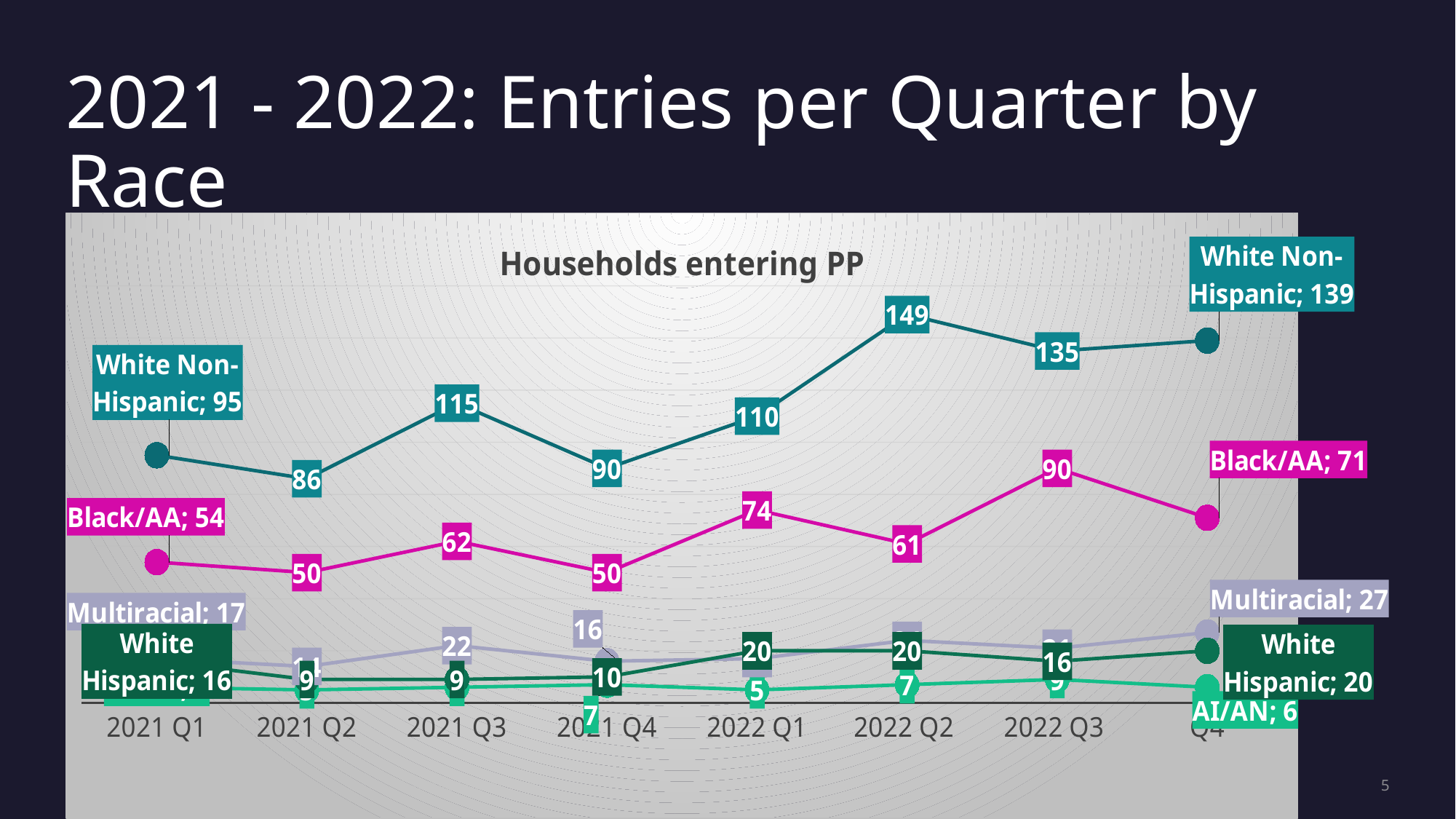
In 2022 Q1, which is larger: White Non-Hispanic or Black/AA? White Non-Hispanic What is the title of the chart? Households entering PP In which quarter does White Non-Hispanic have its lowest value? 2021 Q2 In which quarter does White Non-Hispanic reach its highest value? 2022 Q2 What type of chart is shown on the slide? line chart How many quarters are plotted along the x axis? 8 What is the value for White Non-Hispanic in 2021 Q1? 95 What is the value for Black/AA in 2022 Q3? 90 What is the value for White Non-Hispanic in 2022 Q2? 149 What is the value for Black/AA in 2022 Q4? 71 Does the White Non-Hispanic line rise or fall from 2021 Q4 to 2022 Q2? rise What is the difference between the White Non-Hispanic values in 2022 Q2 and 2022 Q3? 14